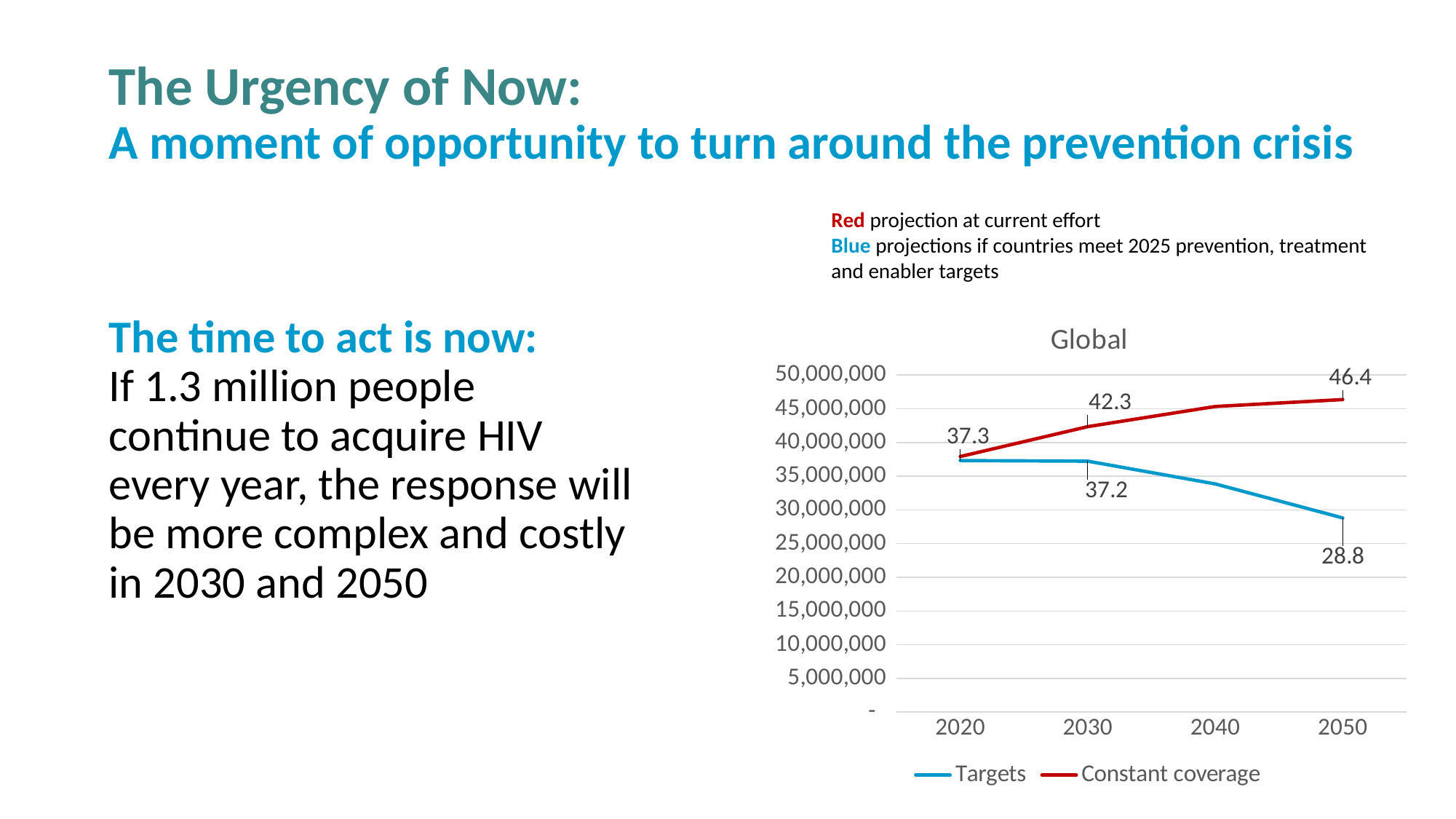
How many years are shown on the x axis of the chart? 4 What is the labelled value for Targets in 2030? 37.2 What is the labelled value for Targets in 2050? 28.8 How many series does the chart legend list? 2 What is the title of the chart? Global What is the labelled value for Constant coverage in 2050? 46.4 What kind of chart is shown on the slide? line chart What is the labelled value for Constant coverage in 2030? 42.3 Is the value for Targets in 2040 greater or less than 30,000,000? greater What is the difference between the Constant coverage and Targets labelled values in 2050? 17.6 Which series has the higher value in 2050, Targets or Constant coverage? Constant coverage Does the Targets line rise or fall from 2020 to 2050? fall